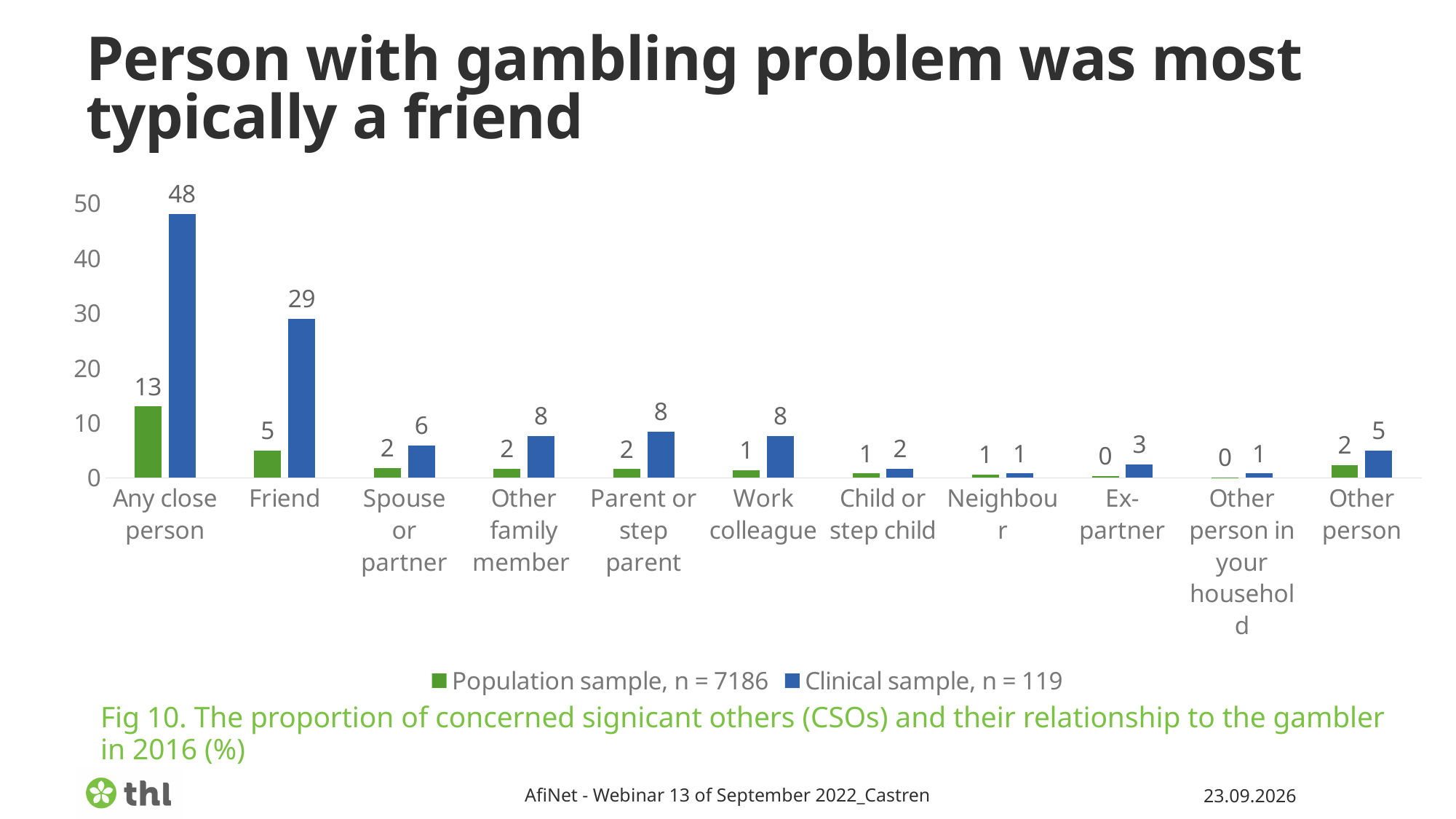
What is the value for the Population sample for Friend? 5 Which colour represents the Population sample in the chart? Green Which category has the highest value for the Clinical sample? Any close person What is the value for the Clinical sample for Ex-partner? 3 Which is larger for Spouse or partner: the Population sample or the Clinical sample? Clinical sample Is the Clinical sample value for Friend greater or less than 20? greater What kind of chart is shown on the slide? Bar chart What is the value for the Clinical sample for Any close person? 48 What is the sample size of the Clinical sample according to the legend? 119 How many series does the legend list? 2 What is the difference between the Clinical sample and Population sample values for Friend? 24 How many categories are shown on the x axis? 11